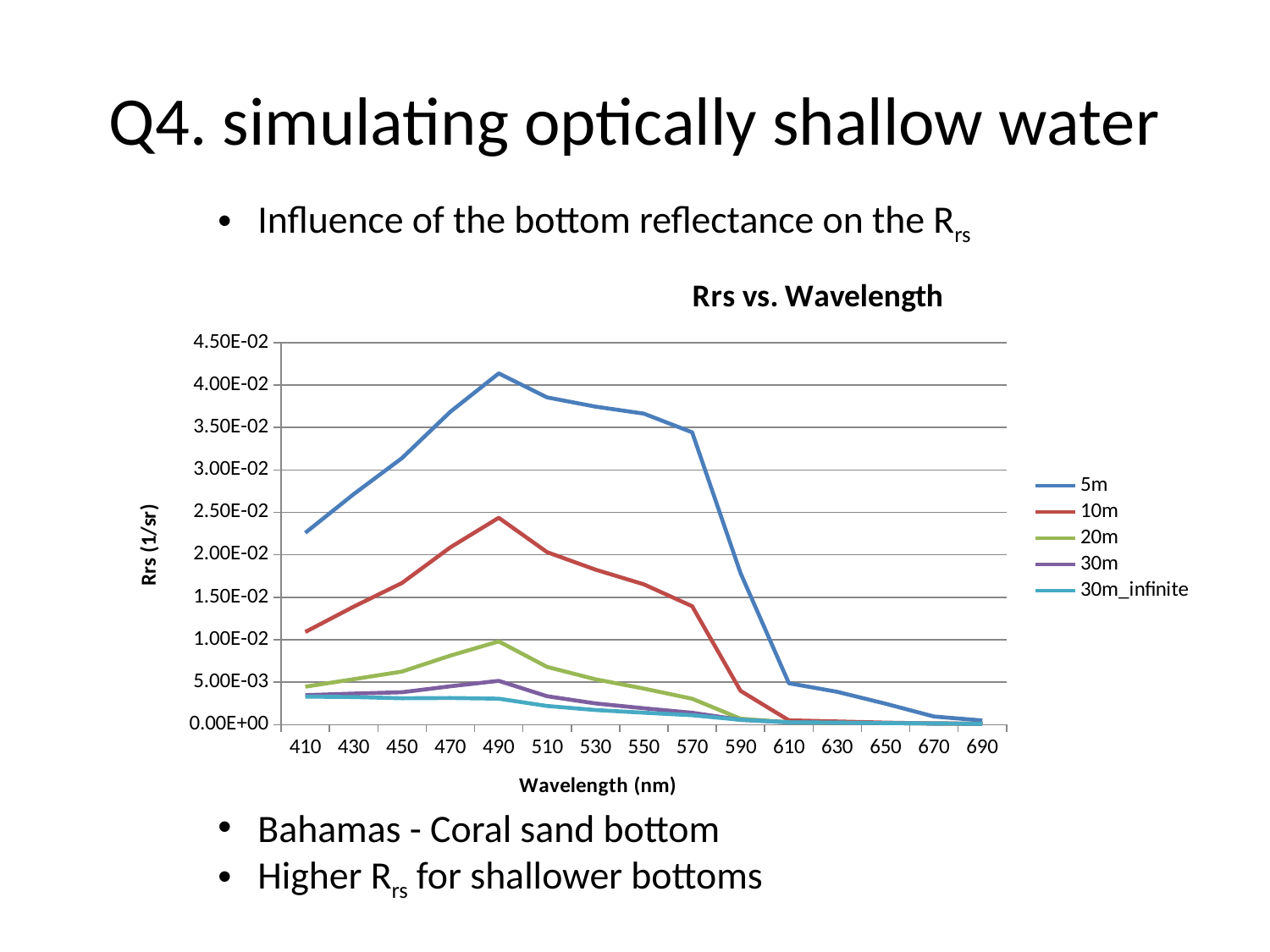
How many wavelength values are labelled on the x axis? 15 Is the value for the 5m series at 490 nm greater or less than 4.00E-02? greater Does the 5m series rise or fall from 490 nm to 690 nm? fall What kind of chart is shown on the slide? line chart How many series does the legend list? 5 Which series has the highest Rrs at 490 nm? 5m Which series has the lowest Rrs values across the wavelengths? 30m_infinite What is the title of the chart? Rrs vs. Wavelength What is the label of the y axis? Rrs (1/sr) At which wavelength does the 5m series reach its peak? 490 Is the value for the 5m series at 410 nm greater or less than 2.00E-02? greater